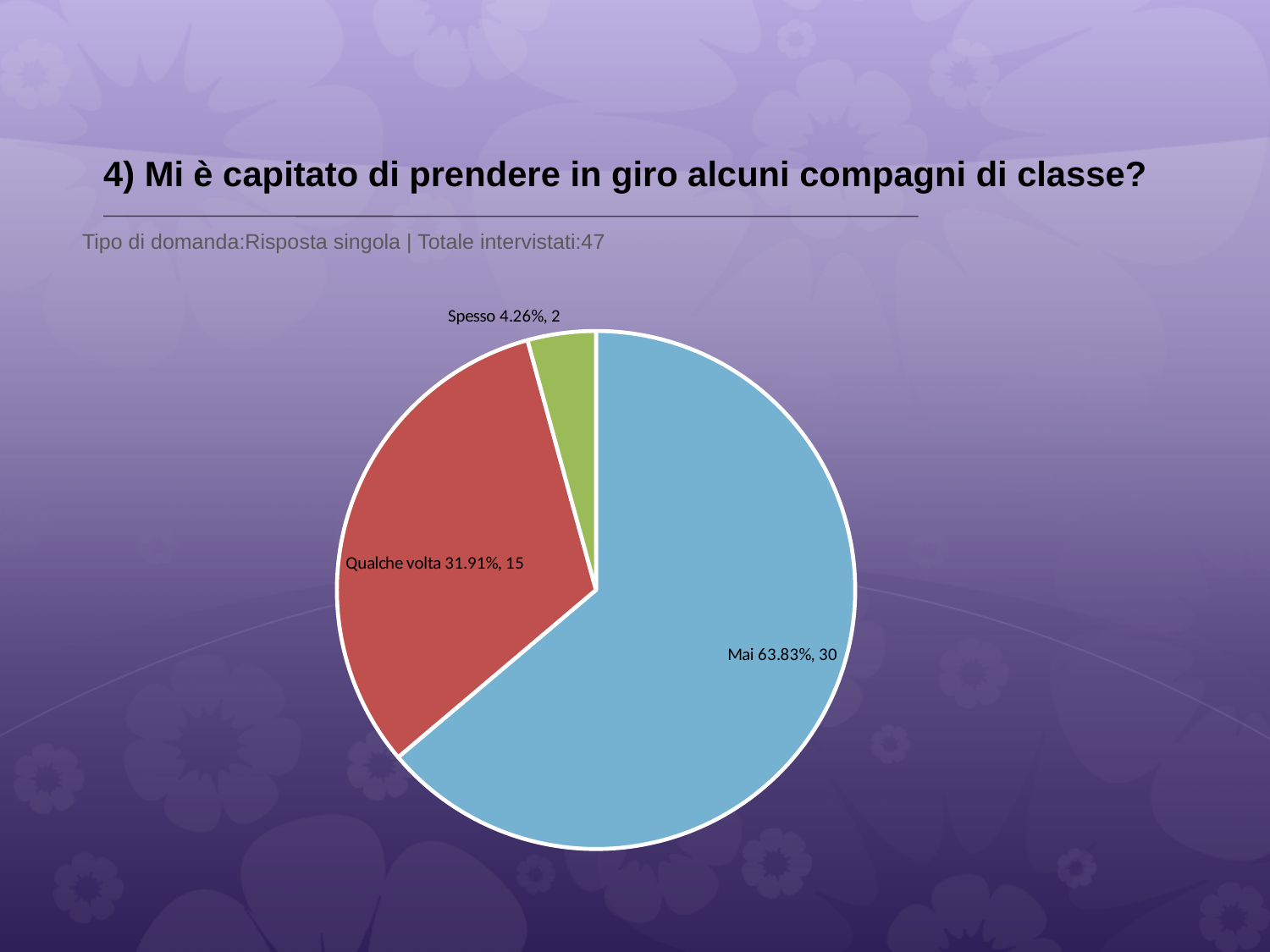
What kind of chart is shown on the slide? pie chart What percentage share does the 'Qualche volta' slice have? 31.91% How many respondents answered 'Mai'? 30 How many slices does the pie chart have? 3 Which slice is larger, 'Qualche volta' or 'Spesso'? Qualche volta Which response has the largest slice of the pie? Mai How many respondents answered 'Spesso'? 2 How many respondents answered 'Qualche volta'? 15 What percentage share does the 'Spesso' slice have? 4.26% What percentage share does the 'Mai' slice have? 63.83% Which response has the smallest slice of the pie? Spesso What is the difference in respondent count between 'Mai' and 'Qualche volta'? 15